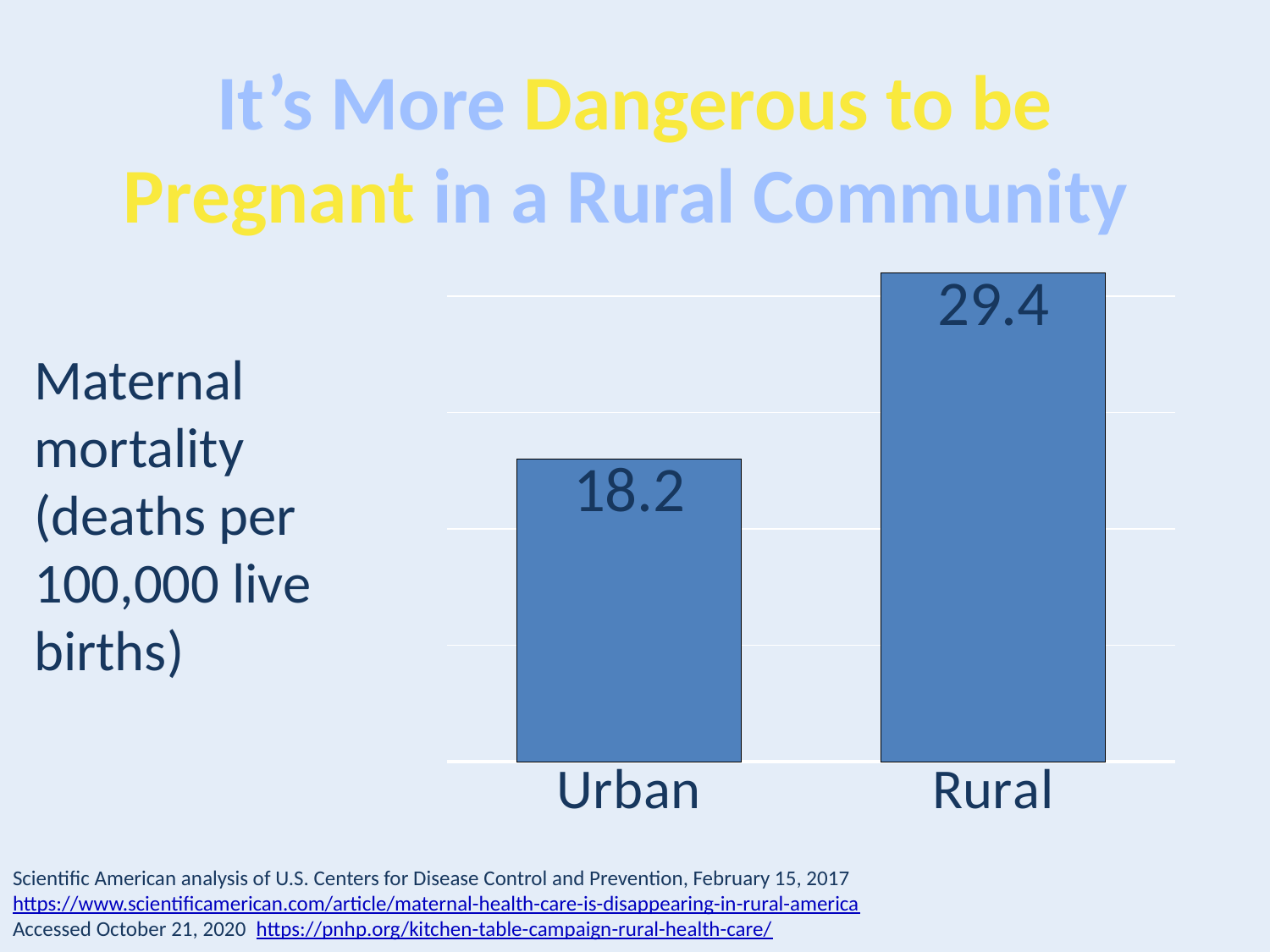
Do the values rise or fall from Urban to Rural? Rise Which category has the higher maternal mortality? Rural How many categories are shown in the chart? 2 What is the difference between the Rural and Urban maternal mortality values? 11.2 What unit is the maternal mortality measured in, according to the slide? Deaths per 100,000 live births Which category has the lower maternal mortality? Urban What is the maternal mortality value for Rural? 29.4 What is the title of the slide? It's More Dangerous to be Pregnant in a Rural Community What is the maternal mortality value for Urban? 18.2 What kind of chart is shown on the slide? Bar chart Is the maternal mortality value larger for Urban or Rural? Rural